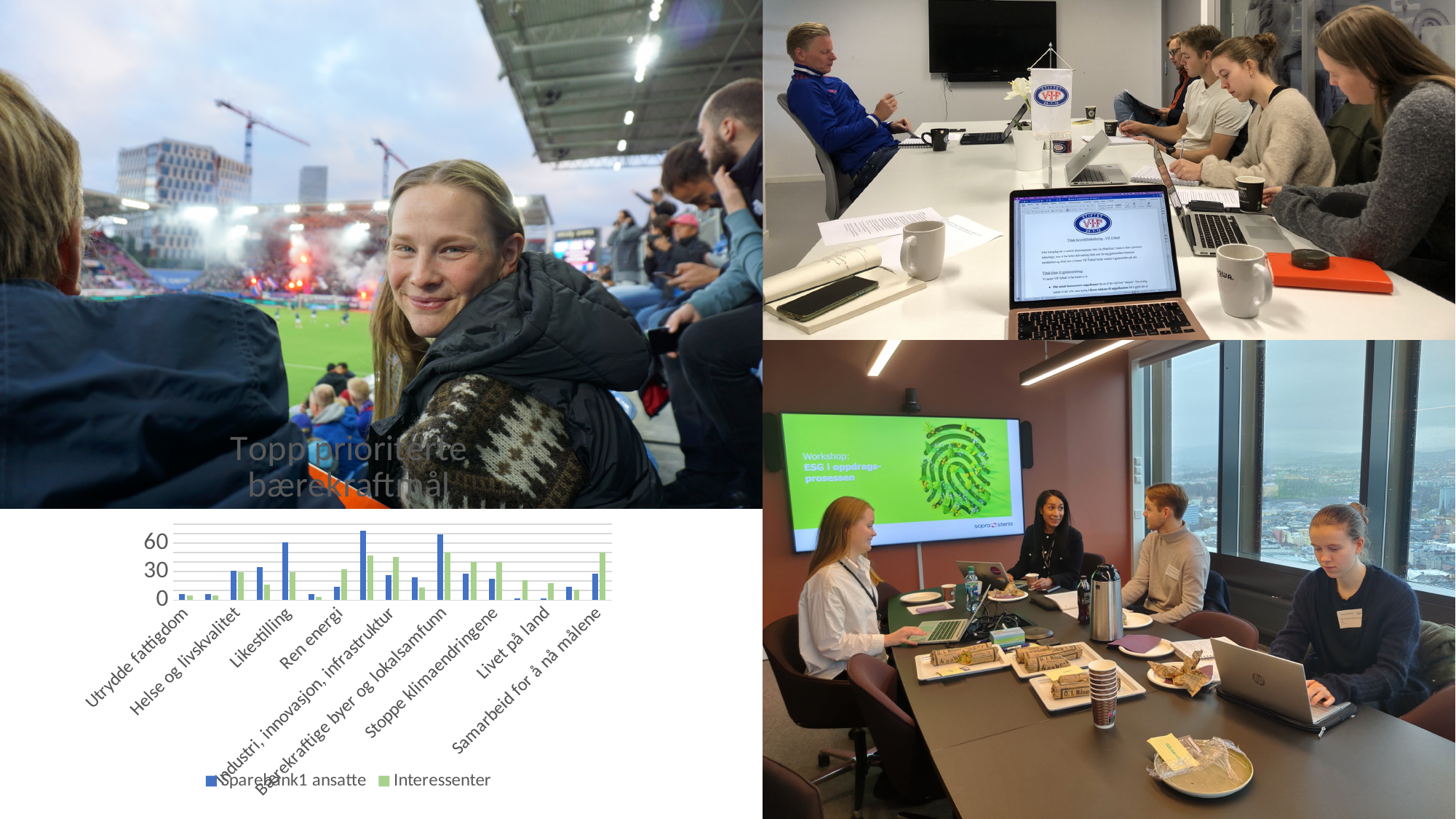
Is the Interessenter value for Utrydde fattigdom greater or less than 30? less How many series does the chart legend list? 2 For Samarbeid for å nå målene, which series has the larger value, Sparebank1 ansatte or Interessenter? Interessenter What is the title of the chart? Topp prioriterte bærekraftmål What kind of chart is shown on the slide? bar chart Is the Sparebank1 ansatte value for Utrydde fattigdom greater or less than 30? less What is the highest value labelled on the vertical axis of the chart? 60 Is the Interessenter value for Samarbeid for å nå målene greater or less than 30? greater What are the two series named in the chart legend? Sparebank1 ansatte and Interessenter